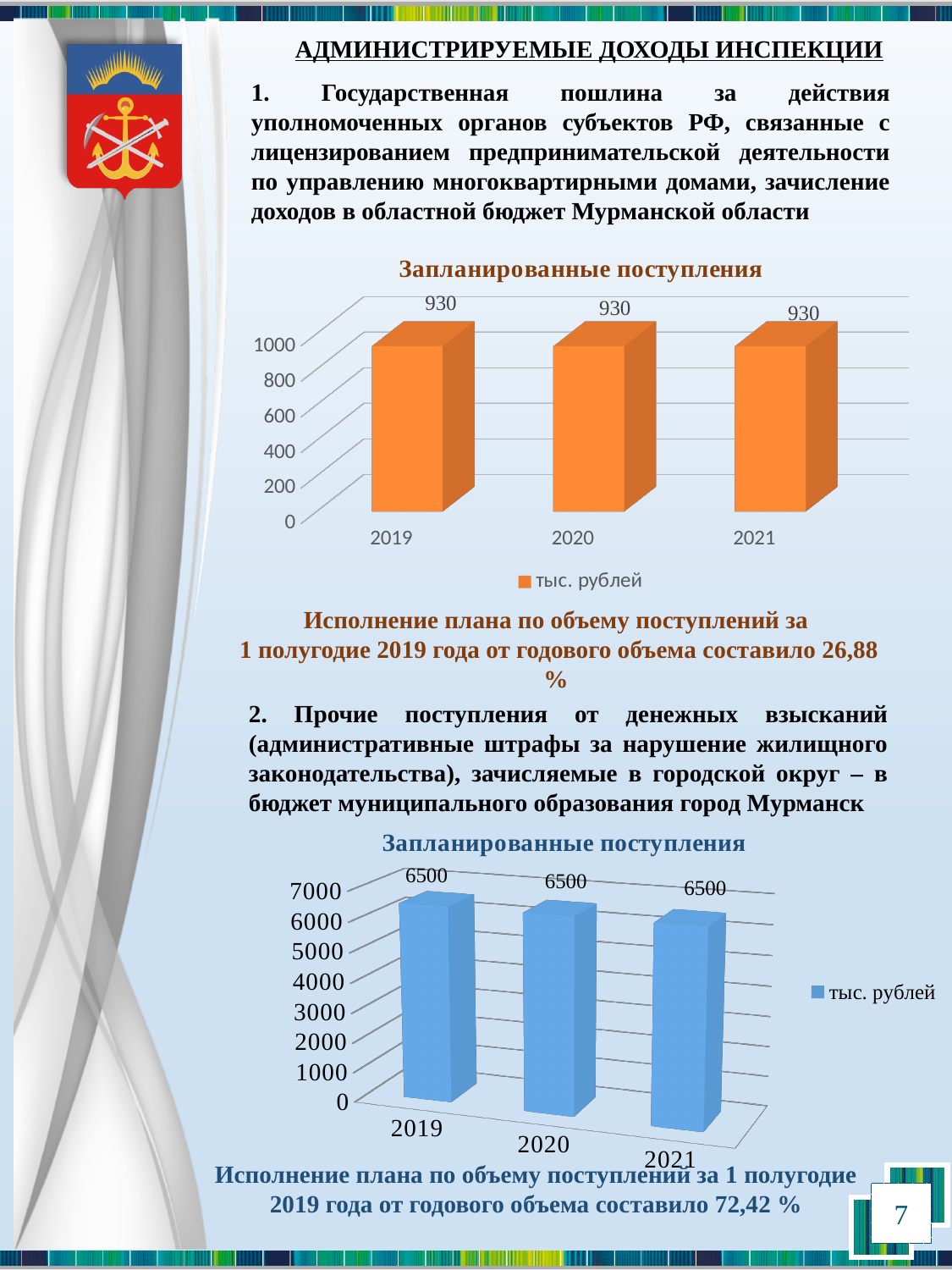
In the upper chart, what is the value for 2021? 930 In the upper chart, what is the difference between the values for 2020 and 2019? 0 How many categories are shown on the x axis of the upper chart? 3 How many bars does the lower chart have? 3 What is the legend entry of the upper chart? тыс. рублей Do the values in the lower chart rise, fall or stay the same from 2019 to 2021? stay the same In the upper chart, what is the value for 2019? 930 In the lower chart, what is the value for 2021? 6500 What kind of chart is the upper chart? bar chart In the lower chart, what is the value for 2020? 6500 What colour are the bars in the lower chart? blue How many series does the legend of the lower chart list? 1